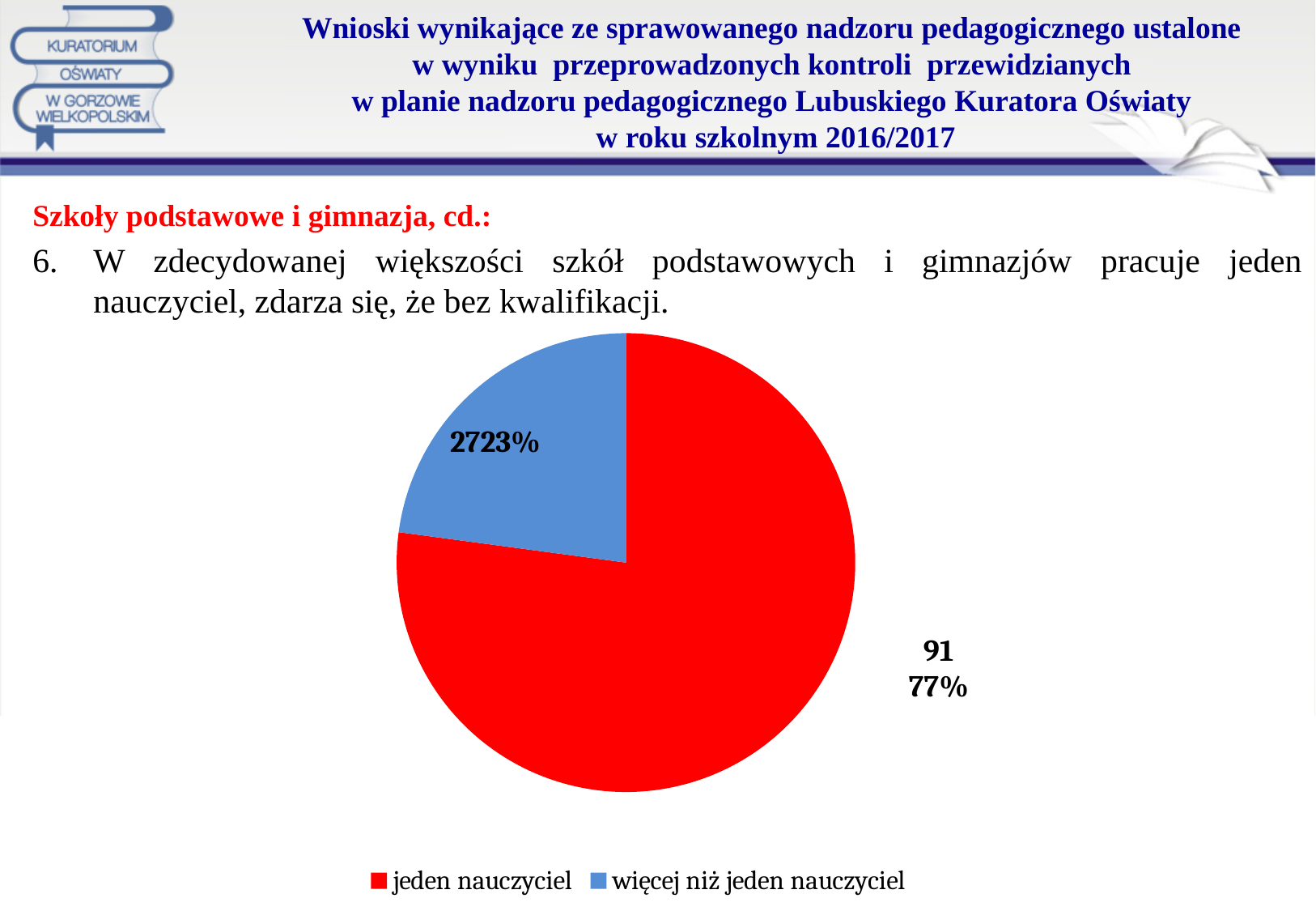
Which slice of the pie chart is the largest? jeden nauczyciel What kind of chart is shown on the slide? pie chart What colour is the 'jeden nauczyciel' slice? red How many entries does the legend of the pie chart list? 2 What colour is the 'więcej niż jeden nauczyciel' slice? blue What is the value shown for the 'jeden nauczyciel' slice? 91 What share of the pie does the 'jeden nauczyciel' slice represent? 77% Which slice of the pie chart is the smallest? więcej niż jeden nauczyciel How many slices does the pie chart have? 2 Which is larger: the 'jeden nauczyciel' slice or the 'więcej niż jeden nauczyciel' slice? jeden nauczyciel